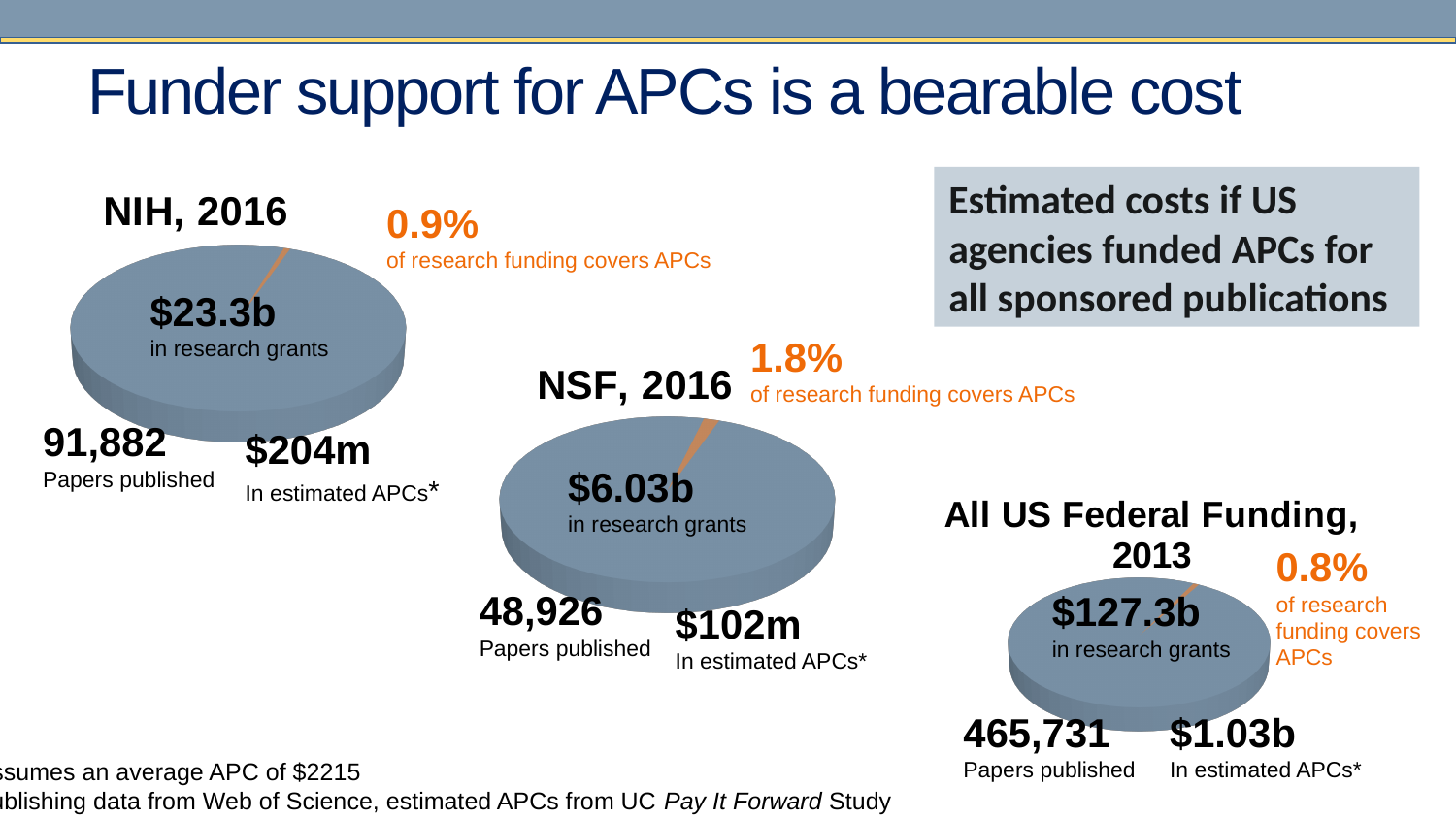
In the All US Federal Funding, 2013 chart, how much is in research grants? $127.3b In the NIH, 2016 chart, what share of research funding covers APCs? 0.9% In the NIH, 2016 chart, how much is in estimated APCs? $204m How many pie charts are shown on the slide? 3 In the NSF, 2016 chart, how much is in research grants? $6.03b Which of the three charts shows the highest percentage of research funding covering APCs? NSF, 2016 In the NIH, 2016 chart, how much is in research grants? $23.3b What kind of chart is used for NIH, 2016? pie chart Which of the three charts shows the lowest percentage of research funding covering APCs? All US Federal Funding, 2013 In the All US Federal Funding, 2013 chart, what share of research funding covers APCs? 0.8% Which has more papers published, NIH, 2016 or NSF, 2016? NIH, 2016 In the NSF, 2016 chart, what share of research funding covers APCs? 1.8%